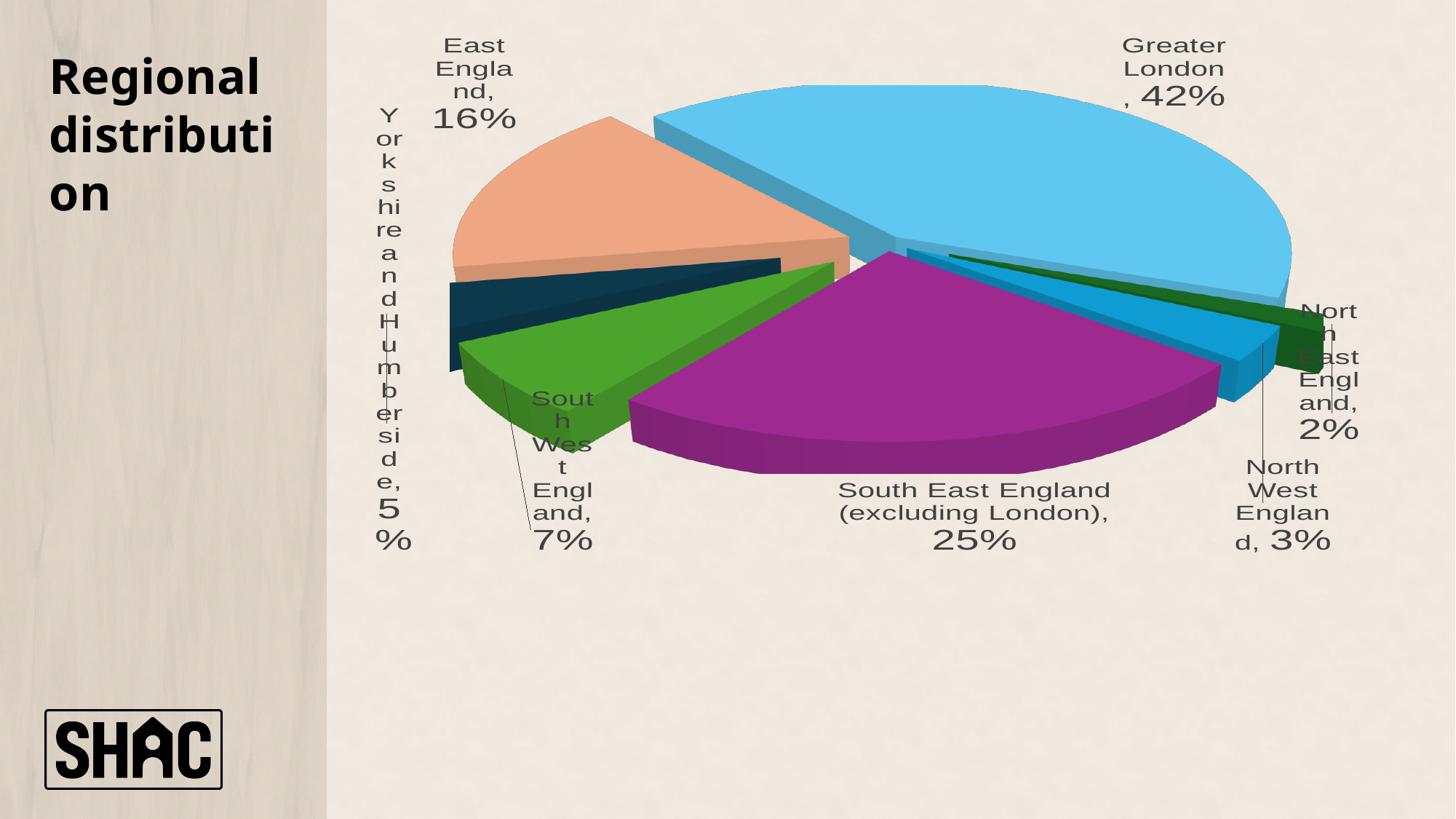
What is the value for North East England? 2% What share of the pie does Greater London have? 42% What is the value for East England? 16% What kind of chart is shown on the slide? pie chart How many regions are shown in the pie chart? 7 What is the value for Yorkshire and Humberside? 5% Which region has the smallest slice of the pie? North East England Which is larger, the share for East England or the share for South West England? East England What is the value for South West England? 7% What is the value for South East England (excluding London)? 25% Which region has the largest slice of the pie? Greater London What is the difference between the Greater London and South East England (excluding London) shares? 17%